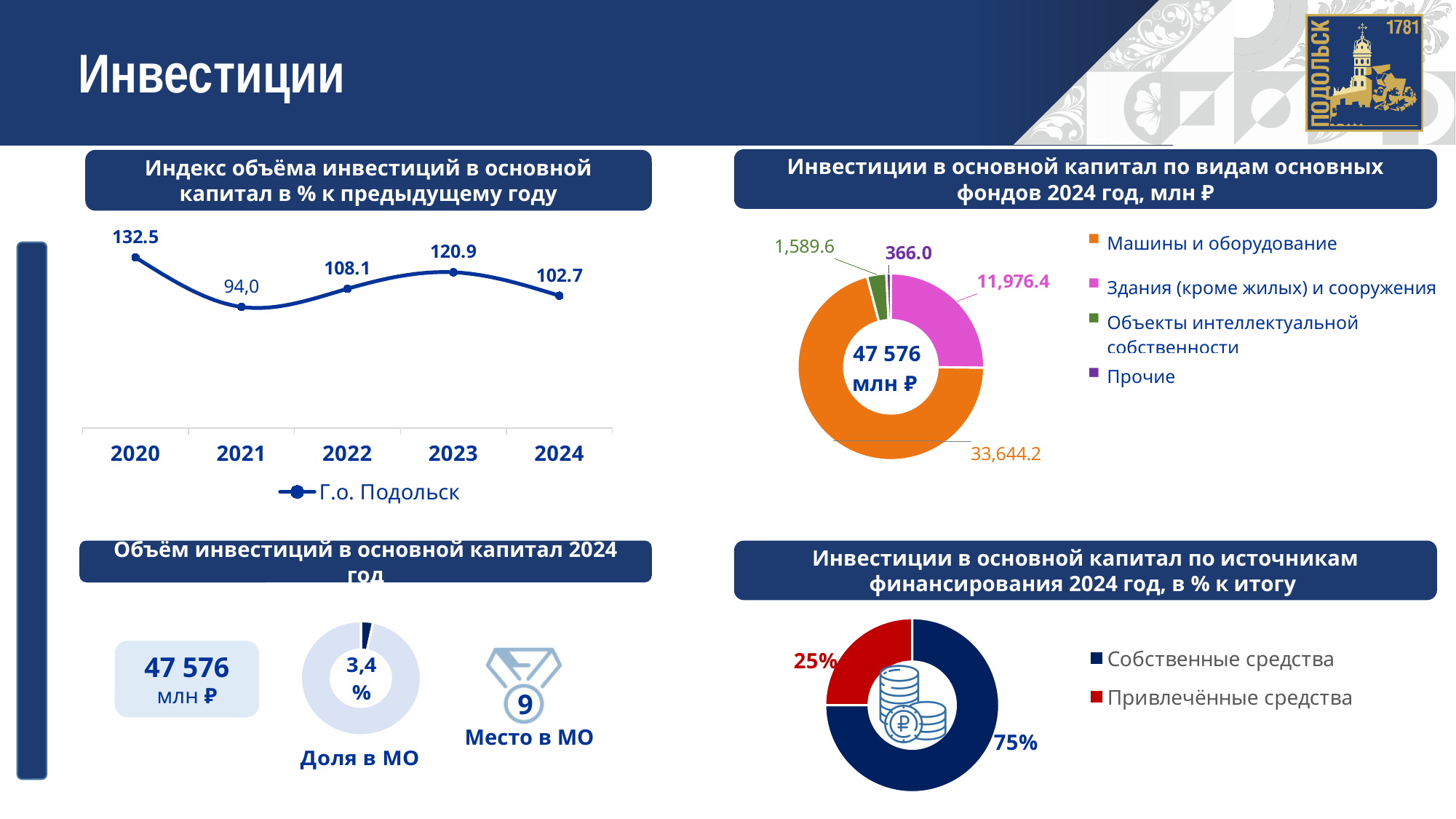
In the chart 'Инвестиции в основной капитал по видам основных фондов 2024 год, млн ₽', which category has the largest value? Машины и оборудование In the chart 'Индекс объёма инвестиций в основной капитал в % к предыдущему году', what is the difference between the 2020 value and the 2024 value? 29.8 In the chart 'Индекс объёма инвестиций в основной капитал в % к предыдущему году', which is larger, the value for 2022 or the value for 2023? 2023 In the chart 'Индекс объёма инвестиций в основной капитал в % к предыдущему году', which year has the lowest value? 2021 In the chart 'Инвестиции в основной капитал по источникам финансирования 2024 год, в % к итогу', what is the share of 'Собственные средства'? 75% How many categories does the legend list in the chart 'Инвестиции в основной капитал по видам основных фондов 2024 год, млн ₽'? 4 In the chart 'Инвестиции в основной капитал по видам основных фондов 2024 год, млн ₽', which category has the smallest value? Прочие In the chart 'Инвестиции в основной капитал по видам основных фондов 2024 год, млн ₽', what is the value for 'Здания (кроме жилых) и сооружения'? 11,976.4 What kind of chart is 'Индекс объёма инвестиций в основной капитал в % к предыдущему году'? line chart In the chart 'Индекс объёма инвестиций в основной капитал в % к предыдущему году', what is the value for 2023? 120.9 How many years are plotted in the chart 'Индекс объёма инвестиций в основной капитал в % к предыдущему году'? 5 In the chart 'Индекс объёма инвестиций в основной капитал в % к предыдущему году', which year has the highest value? 2020